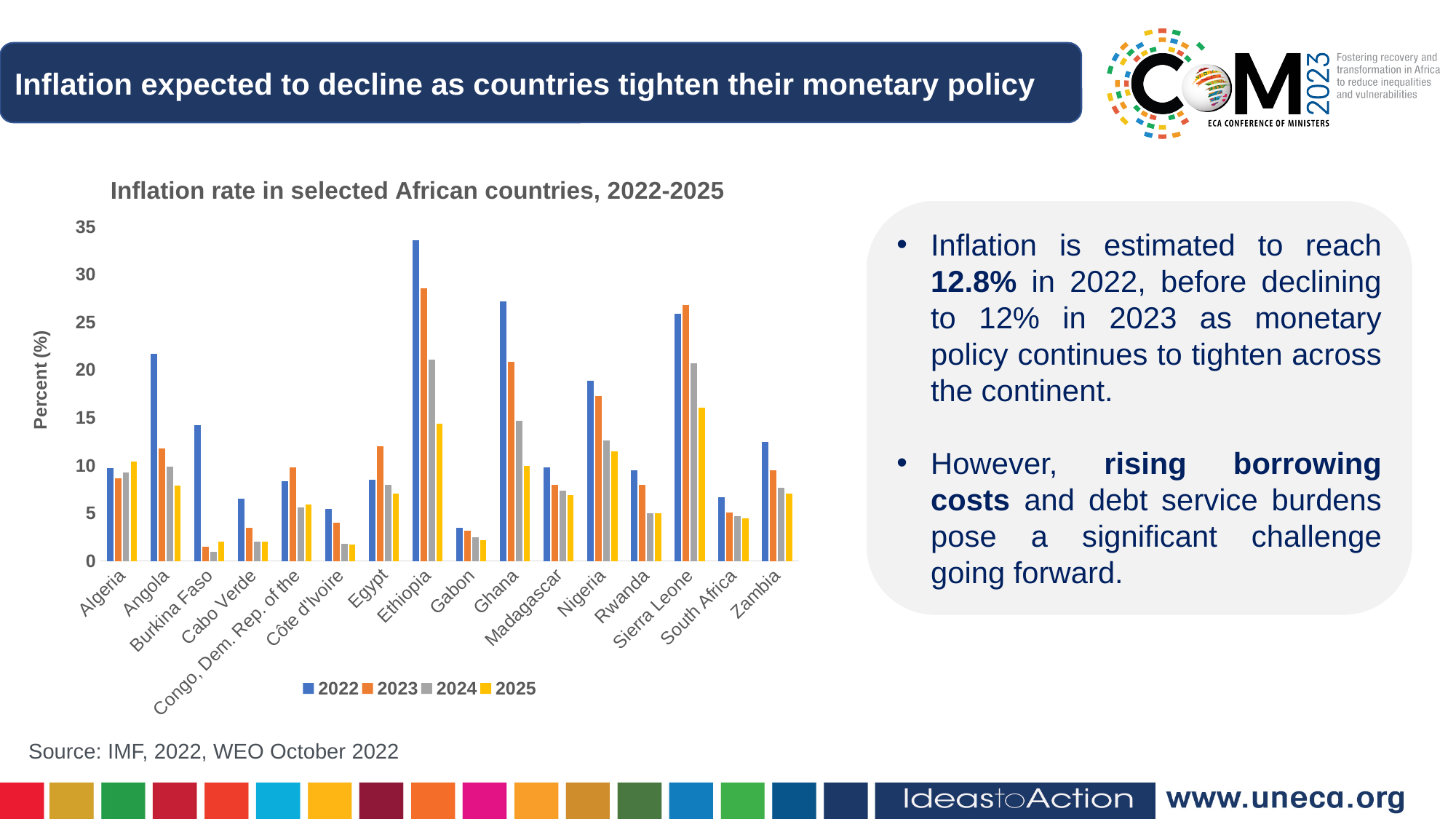
How many countries are shown on the x axis of the chart? 16 Which is larger, the 2023 value for Sierra Leone or the 2023 value for Ghana? Sierra Leone How many series does the chart legend list? 4 Is the 2022 value for Angola greater or less than 20? greater Which country has the lowest inflation rate for 2022? Gabon What kind of chart is shown on the slide? Bar chart Which is larger, the 2022 value for Angola or the 2022 value for Nigeria? Angola Which country has the highest inflation rate for 2022? Ethiopia Is the 2022 value for Ethiopia greater or less than 30? greater Do the values for Ethiopia rise or fall from 2022 to 2025? Fall Is the 2023 value for Burkina Faso greater or less than 5? less What is the title of the chart? Inflation rate in selected African countries, 2022-2025